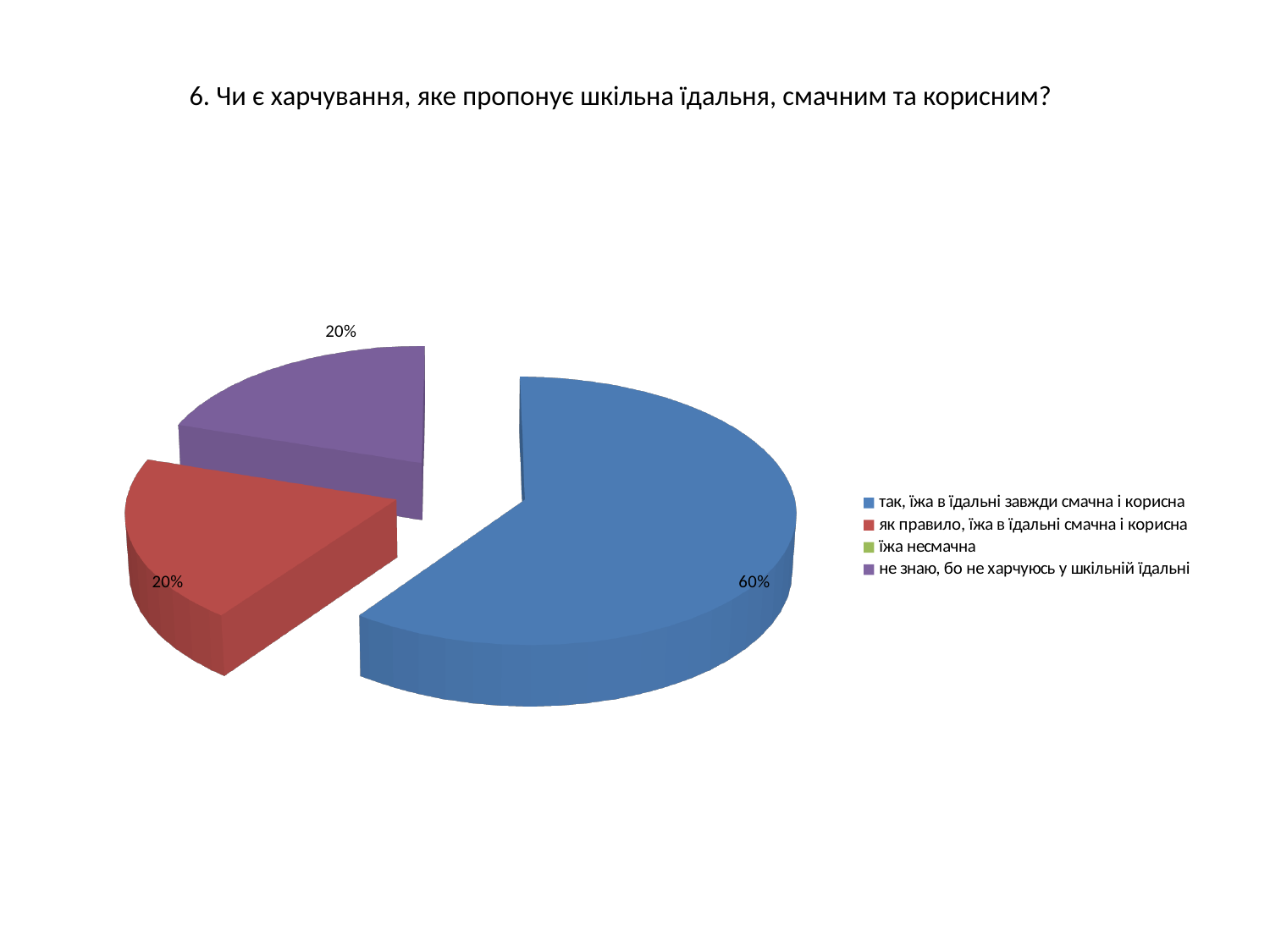
Which is larger: the share for "так, їжа в їдальні завжди смачна і корисна" or the share for "не знаю, бо не харчуюсь у шкільній їдальні"? так, їжа в їдальні завжди смачна і корисна What is the difference in percentage points between "так, їжа в їдальні завжди смачна і корисна" and "як правило, їжа в їдальні смачна і корисна"? 40 percentage points How many answer options does the legend list? 4 What percentage of respondents answered "так, їжа в їдальні завжди смачна і корисна"? 60% What percentage of respondents answered "не знаю, бо не харчуюсь у шкільній їдальні"? 20% What share of the pie does the blue slice represent? 60% Which colour represents "їжа несмачна" in the legend? Green Which answer option has the largest share of the pie? так, їжа в їдальні завжди смачна і корисна How many slices with printed percentages are visible in the pie? 3 What kind of chart is shown on the slide? Pie chart What is the title of the chart? 6. Чи є харчування, яке пропонує шкільна їдальня, смачним та корисним? What percentage of respondents answered "як правило, їжа в їдальні смачна і корисна"? 20%